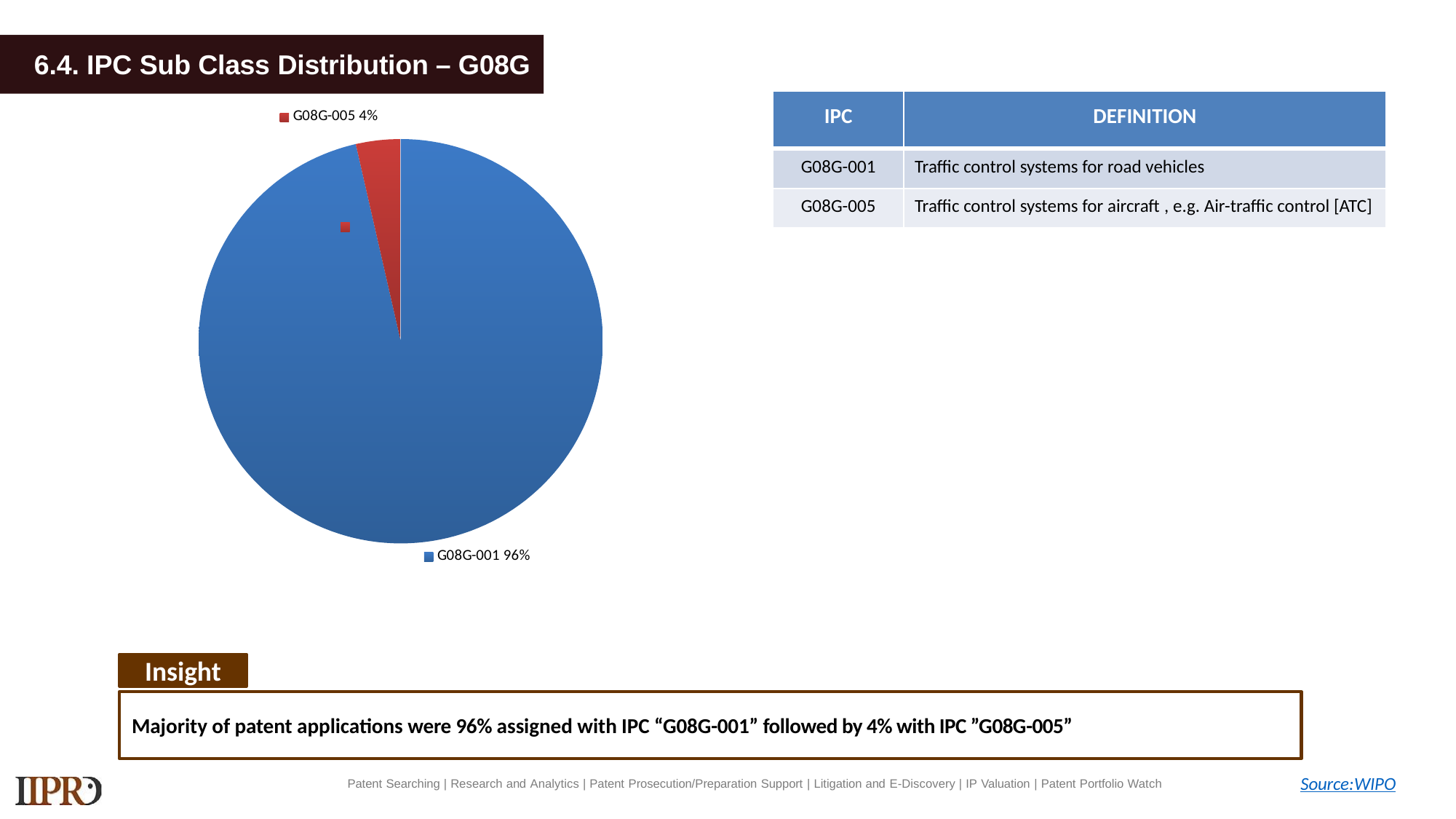
What is the combined share of the G08G-001 and G08G-005 slices? 100% Which slice is larger, G08G-001 or G08G-005? G08G-001 How many slices does the pie chart have? 2 What colour is the G08G-005 slice of the pie? Red What share of the pie does G08G-001 represent? 96% What is the difference in percentage points between the G08G-001 and G08G-005 slices? 92 What is the title of the slide containing the pie chart? 6.4. IPC Sub Class Distribution – G08G Which IPC sub class has the largest slice of the pie? G08G-001 What kind of chart is shown on the slide? Pie chart What share of the pie does G08G-005 represent? 4% Which IPC sub class has the smallest slice of the pie? G08G-005